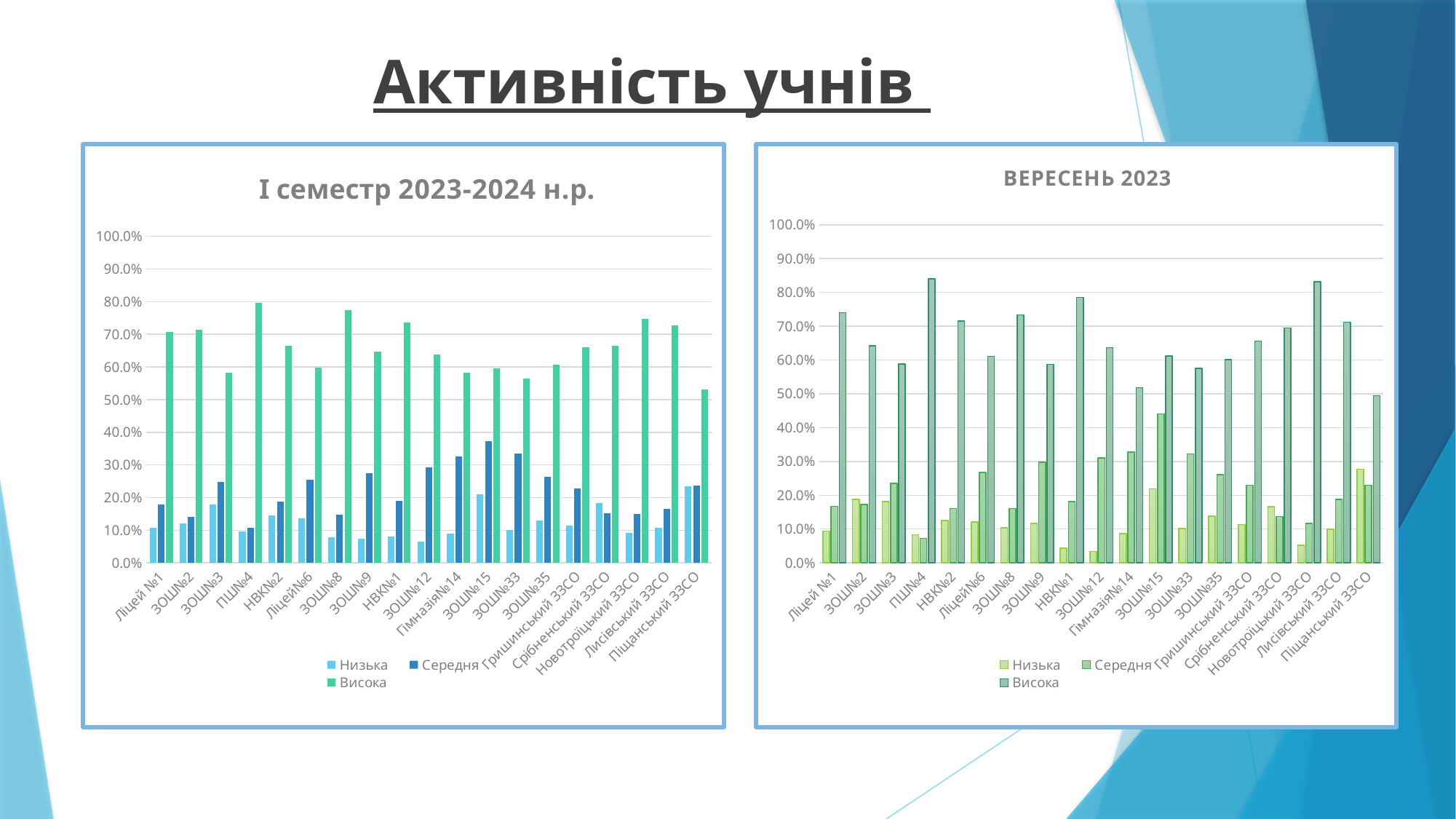
What kind of chart is the chart titled "І семестр 2023-2024 н.р."? bar chart In the chart titled "ВЕРЕСЕНЬ 2023", which has the larger Висока value: НВК№1 or ЗОШ№15? НВК№1 In the chart titled "ВЕРЕСЕНЬ 2023", is the Висока value for ЗОШ№15 greater or less than 50.0%? greater How many categories are shown on the x axis of the chart titled "І семестр 2023-2024 н.р."? 19 In the chart titled "ВЕРЕСЕНЬ 2023", which category has the lowest value for the Висока series? Піщанський ЗЗСО In the chart titled "ВЕРЕСЕНЬ 2023", which category has the highest value for the Низька series? Піщанський ЗЗСО In the chart titled "І семестр 2023-2024 н.р.", is the Висока value for ПШ№4 greater or less than 70.0%? greater In the chart titled "І семестр 2023-2024 н.р.", which category has the highest value for the Середня series? ЗОШ№15 What is the title of the chart on the right side of the slide? ВЕРЕСЕНЬ 2023 In the chart titled "І семестр 2023-2024 н.р.", which category has the lowest value for the Висока series? Піщанський ЗЗСО In the chart titled "ВЕРЕСЕНЬ 2023", is the Низька value for Піщанський ЗЗСО greater or less than 20.0%? greater How many series does the legend of the chart titled "ВЕРЕСЕНЬ 2023" list? 3